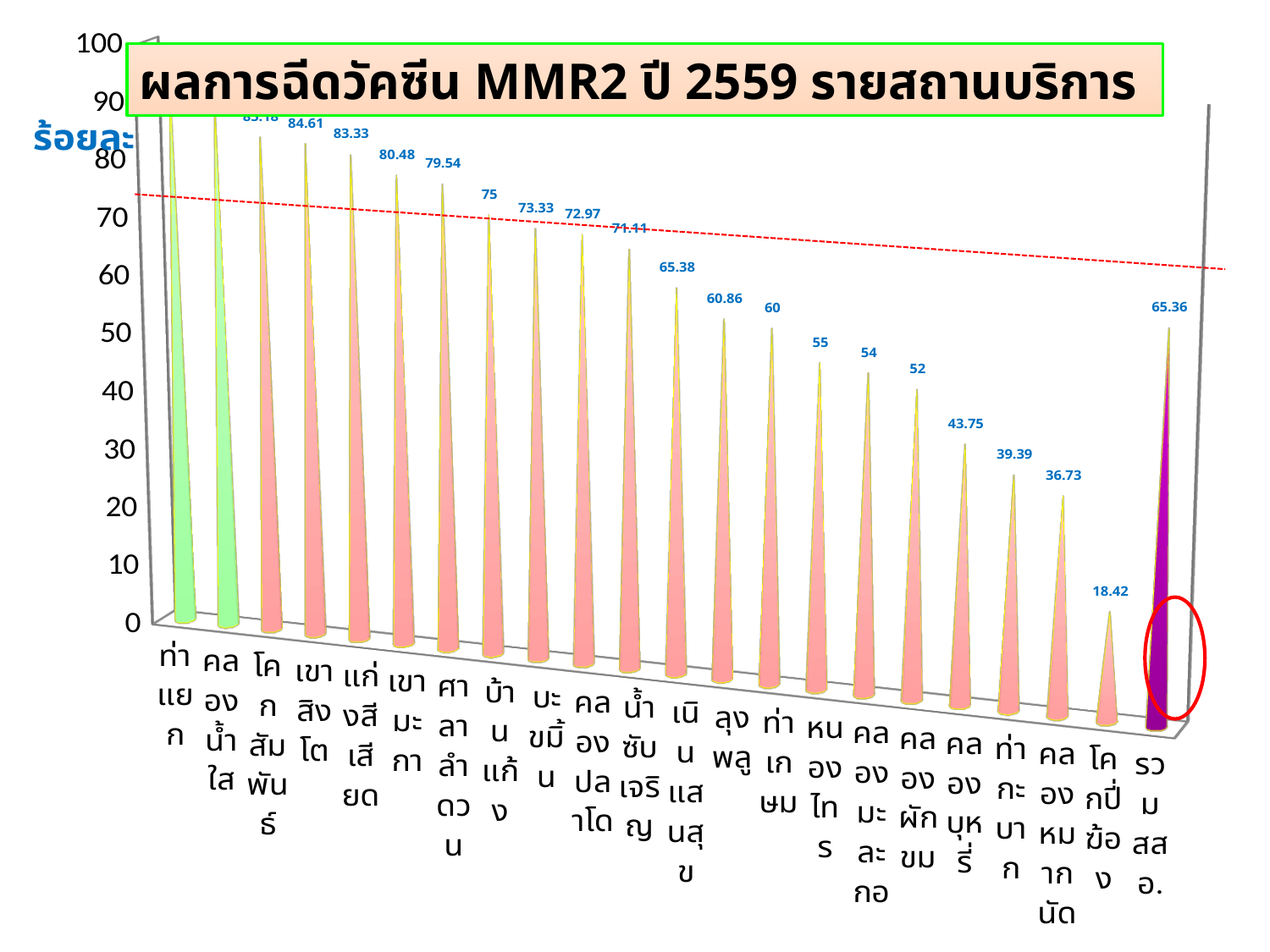
What is the value for โคกปี่ฆ้อง? 18.42 What is the value for คลองบุหรี่? 43.75 What is the value for รวม สสอ.? 65.36 What is the value for บ้านแก้ง? 75 Which is larger, the value for ลุงพลู or the value for ท่าเกษม? ลุงพลู What is the title of the chart? ผลการฉีดวัคซีน MMR2 ปี 2559 รายสถานบริการ Which category has the highest value? ท่าแยก What kind of chart is shown on the slide? bar chart Which category has the lowest value? โคกปี่ฆ้อง Is the value for คลองน้ำใส greater or less than 80? greater How many categories are shown on the x axis? 22